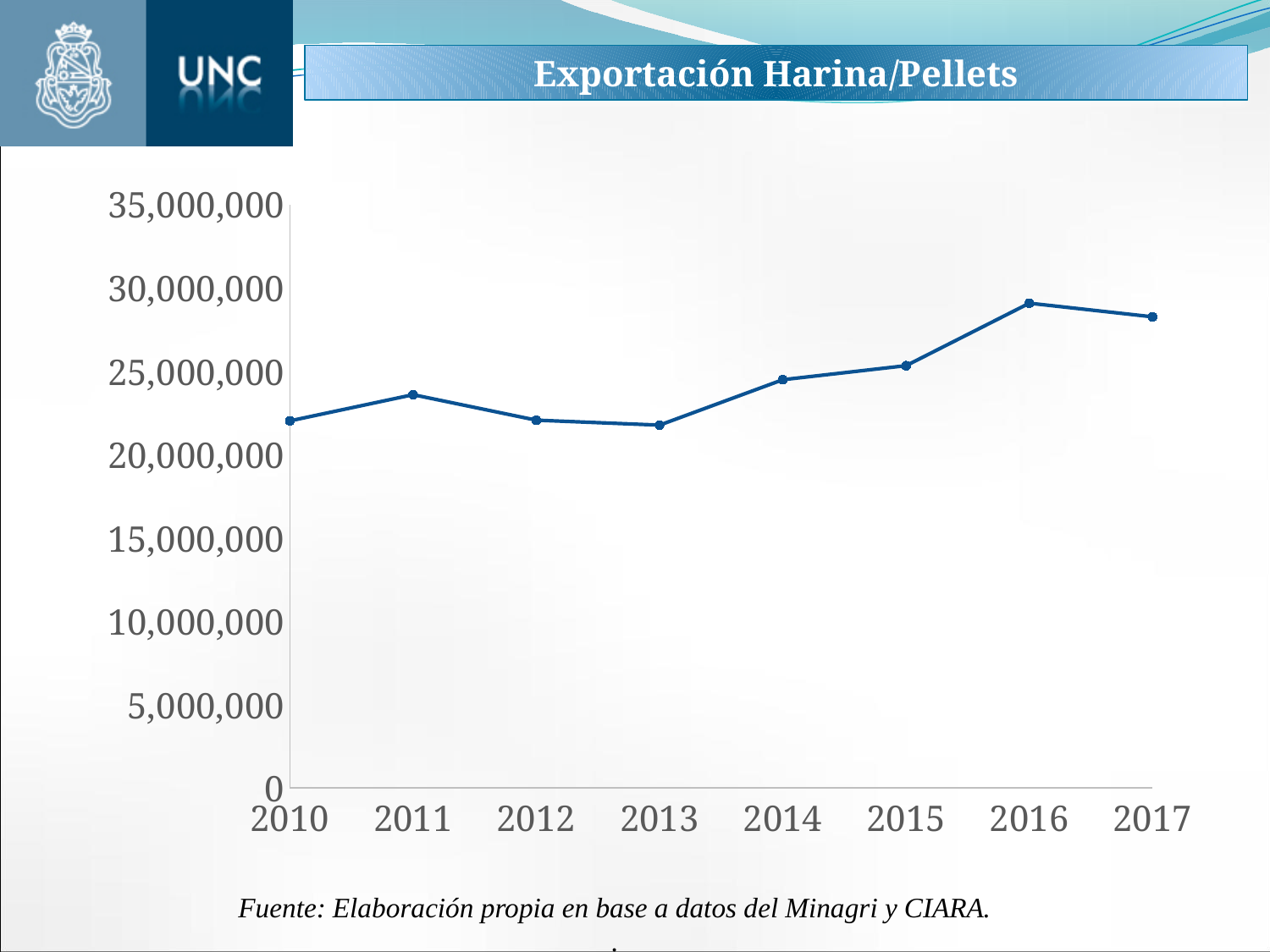
How many years are plotted on the x axis? 8 Is the value for 2017 greater or less than 30,000,000? less Is the value for 2013 greater or less than 25,000,000? less Overall, do the values rise or fall from 2010 to 2017? rise Which is larger, the value for 2011 or the value for 2013? 2011 Which is larger, the value for 2016 or the value for 2013? 2016 Is the value for 2016 greater or less than 25,000,000? greater What kind of chart is shown on the slide? Line chart What source is cited below the chart? Elaboración propia en base a datos del Minagri y CIARA. Which year has the highest value? 2016 What is the title of the chart? Exportación Harina/Pellets